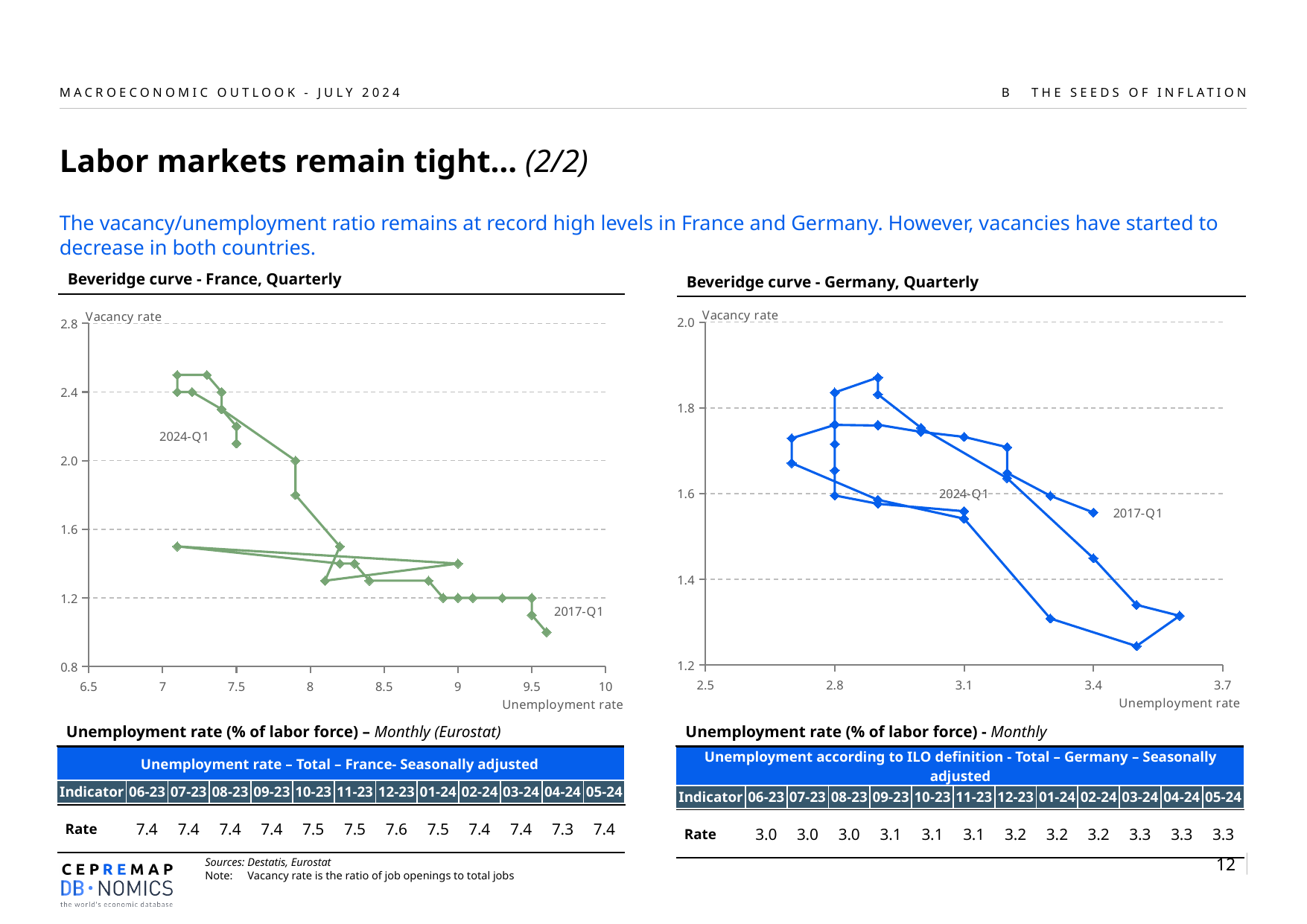
In the Beveridge curve - Germany, Quarterly chart, is the vacancy rate at the point labelled 2017-Q1 greater or less than 1.4? greater What kind of chart is the Beveridge curve - France, Quarterly chart? line chart In the Beveridge curve - Germany, Quarterly chart, is the unemployment rate at the point labelled 2017-Q1 greater or less than 3.1? greater In the Beveridge curve - Germany, Quarterly chart, is the unemployment rate at the point labelled 2024-Q1 greater or less than 3.4? less In the Beveridge curve - France, Quarterly chart, what is the label of the x axis? Unemployment rate In the Beveridge curve - Germany, Quarterly chart, what is the label of the y axis? Vacancy rate In the Beveridge curve - Germany, Quarterly chart, which point has the higher unemployment rate, 2017-Q1 or 2024-Q1? 2017-Q1 In the Beveridge curve - France, Quarterly chart, which point has the higher vacancy rate, 2017-Q1 or 2024-Q1? 2024-Q1